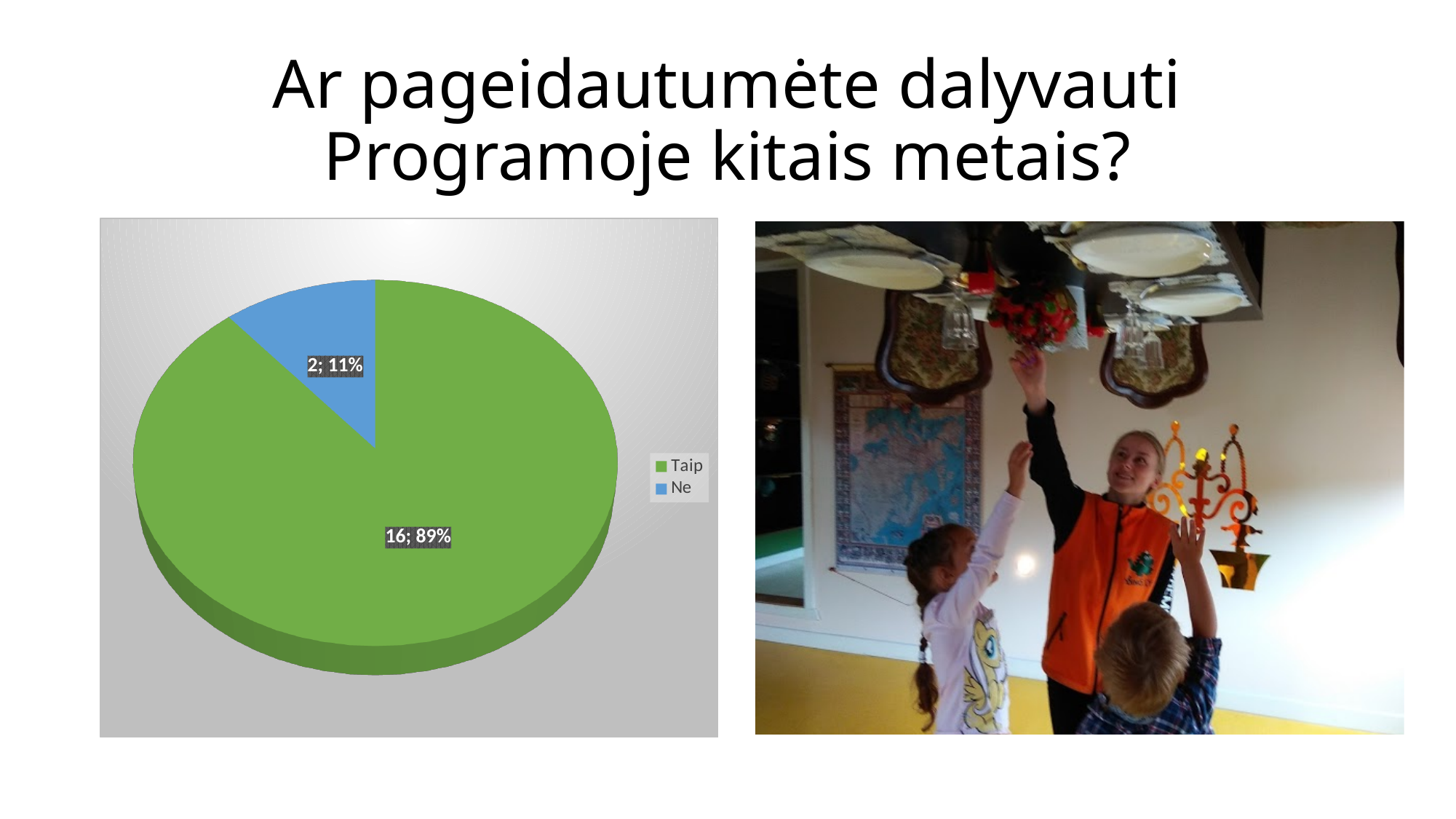
Which category has the smallest slice? Ne What is the count for Taip? 16 What kind of chart is shown on the slide? pie chart How many slices does the pie chart have? 2 Which category has the largest slice? Taip What share of the pie does Ne represent? 11% Which is larger, the count for Taip or the count for Ne? Taip What is the difference between the counts for Taip and Ne? 14 What colour is the Ne slice? blue How many entries does the legend list? 2 What share of the pie does Taip represent? 89% What is the count for Ne? 2